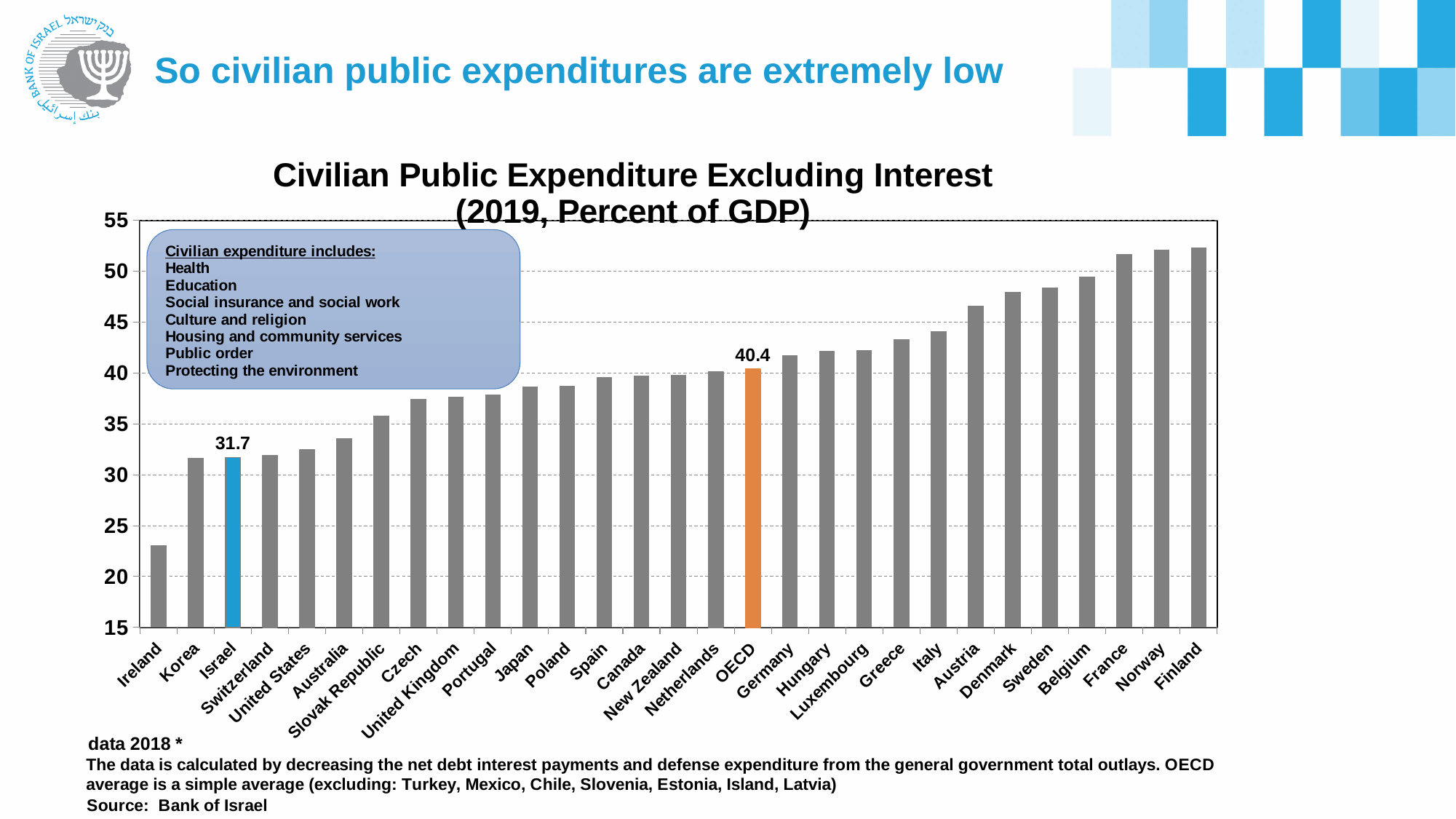
What kind of chart is shown on the slide? Bar chart Which country has the lowest civilian public expenditure? Ireland What is the value for Israel? 31.7 Which has the larger value, Israel or OECD? OECD Is the value for Austria greater or less than 45? greater Is the value for Ireland greater or less than 25? less Do the values rise or fall from left to right along the x axis? Rise What is the value for OECD? 40.4 Is the value for Finland greater or less than 50? greater What is the difference between the OECD value and the Israel value? 8.7 How many bars are shown in the chart? 29